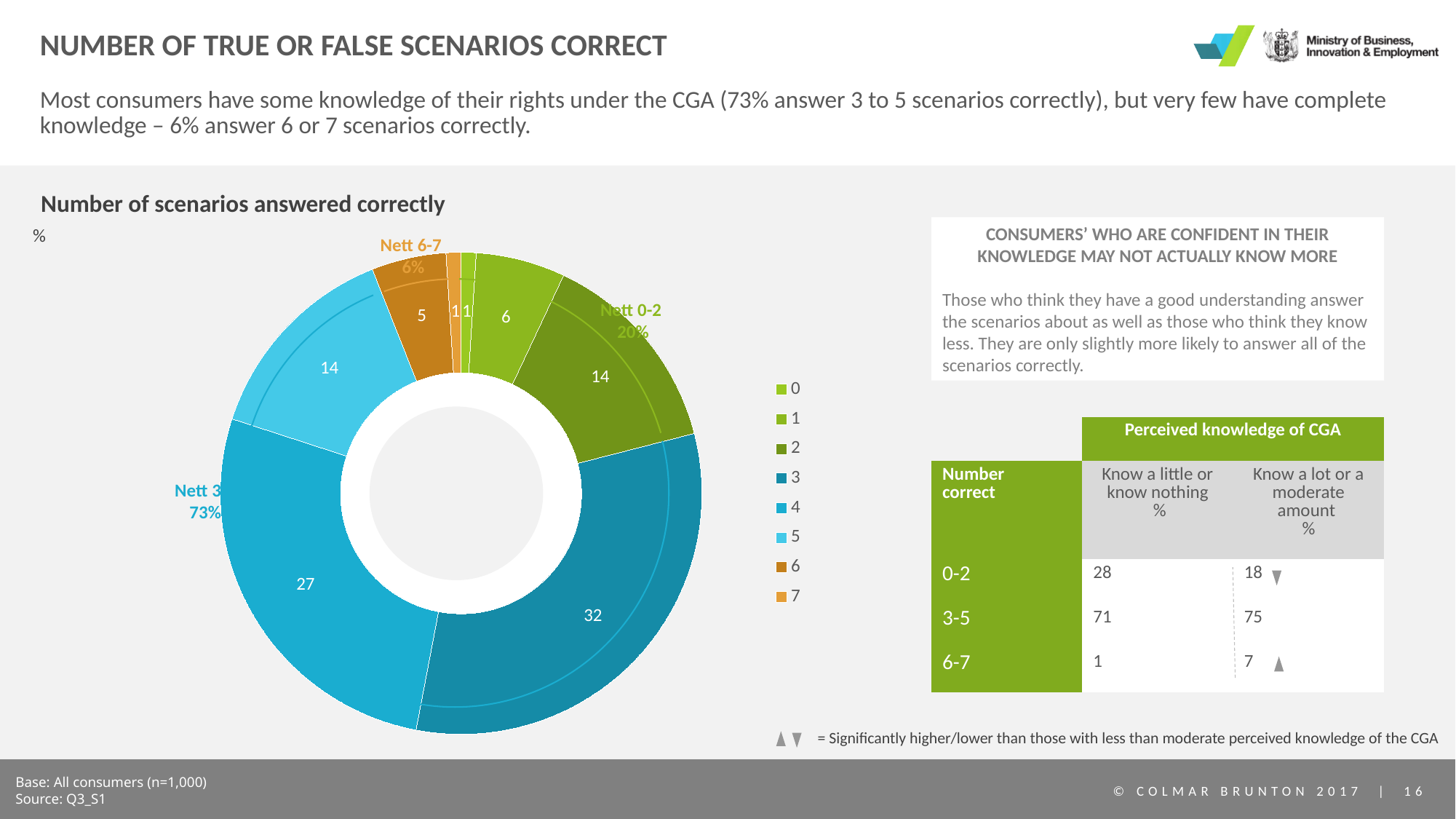
What is the Nett 3-5 share shown on the 'Number of scenarios answered correctly' chart? 73% In the 'Number of scenarios answered correctly' chart, what percentage of consumers answered 4 scenarios correctly? 27 In the 'Number of scenarios answered correctly' chart, what value is shown for 6 scenarios correct? 5 What is the Nett 0-2 share shown on the 'Number of scenarios answered correctly' chart? 20% In the 'Number of scenarios answered correctly' chart, what percentage of consumers answered 3 scenarios correctly? 32 How many entries does the legend of the 'Number of scenarios answered correctly' chart list? 8 In the 'Number of scenarios answered correctly' chart, which is larger: the value for 4 correct or the value for 5 correct? 4 correct In the 'Number of scenarios answered correctly' chart, what is the difference between the values for 3 correct and 4 correct? 5 In the 'Number of scenarios answered correctly' chart, what value is shown for 5 scenarios correct? 14 What is the title of the chart on the slide? Number of scenarios answered correctly Which number of scenarios correct has the largest slice in the 'Number of scenarios answered correctly' chart? 3 What kind of chart is used to show the number of scenarios answered correctly? doughnut (pie) chart